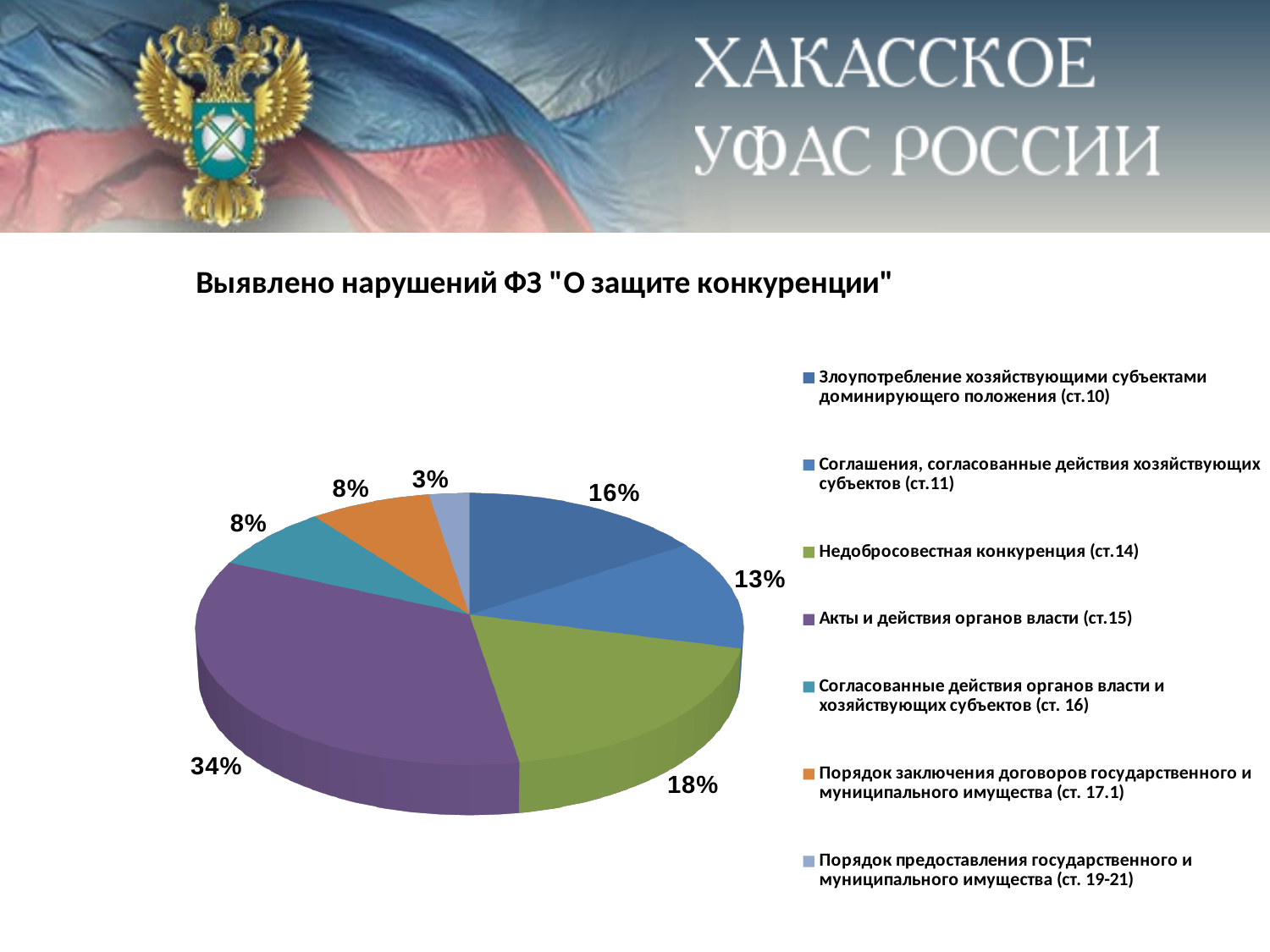
What is the difference in percentage points between the share for ст.15 and the share for ст.14? 16 What is the title of the chart? Выявлено нарушений ФЗ "О защите конкуренции" What type of chart is shown on the slide? pie chart What share of the pie is "Недобросовестная конкуренция (ст.14)"? 18% Which category has the smallest share of the pie? Порядок предоставления государственного и муниципального имущества (ст. 19-21) What share of the pie is "Порядок предоставления государственного и муниципального имущества (ст. 19-21)"? 3% What share of the pie is "Акты и действия органов власти (ст.15)"? 34% Which category has the largest share of the pie? Акты и действия органов власти (ст.15) How many entries does the legend list? 7 How many slices does the pie chart have? 7